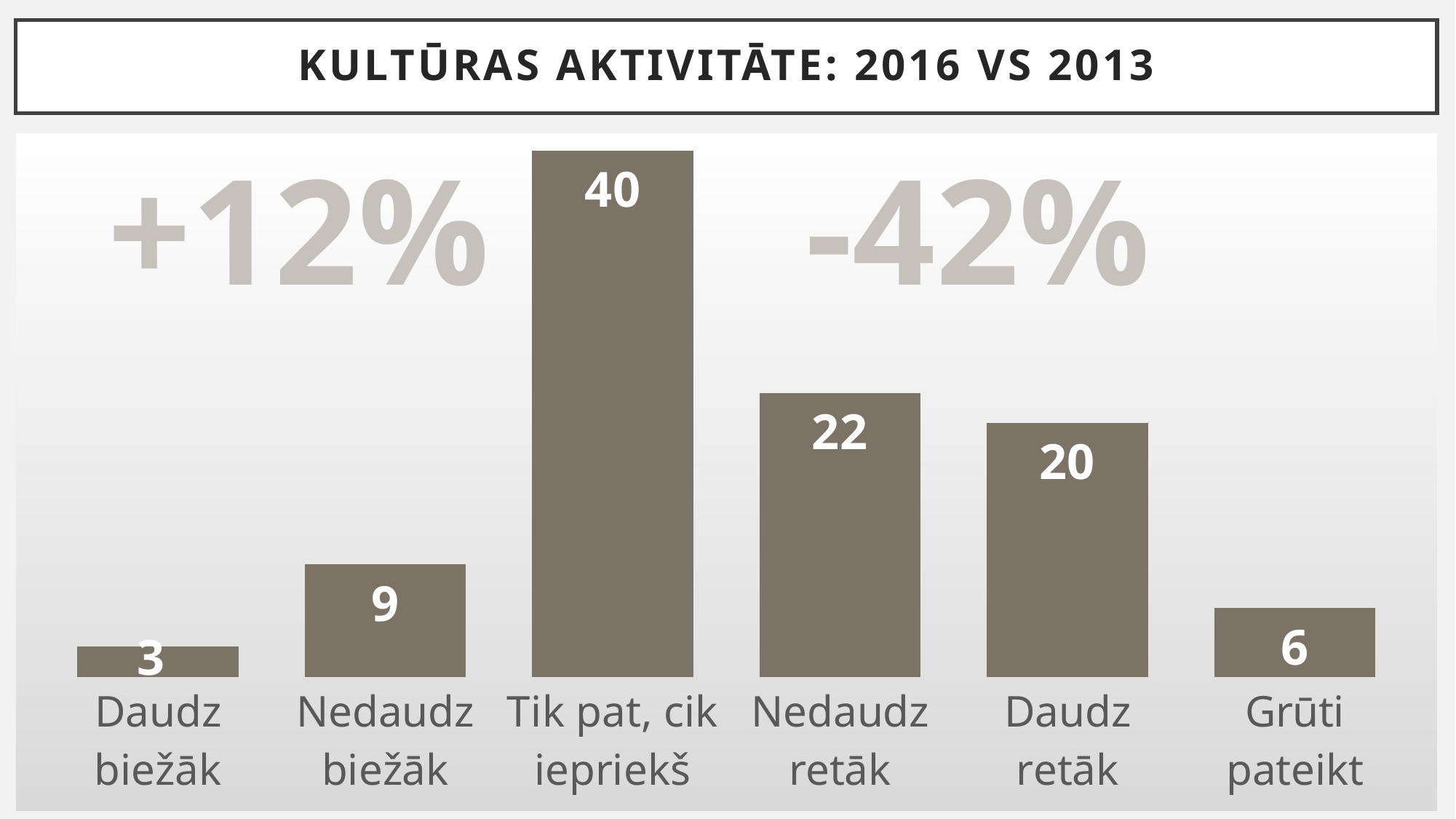
What is the value for "Grūti pateikt"? 6 Which is larger, the value for "Nedaudz biežāk" or the value for "Grūti pateikt"? Nedaudz biežāk What is the value for "Nedaudz retāk"? 22 What is the value for "Tik pat, cik iepriekš"? 40 How many categories are shown in the chart? 6 Which category has the lowest value? Daudz biežāk What is the title of the chart? KULTŪRAS AKTIVITĀTE: 2016 VS 2013 Which category has the highest value? Tik pat, cik iepriekš What is the difference between the values for "Tik pat, cik iepriekš" and "Nedaudz biežāk"? 31 What is the difference between the values for "Nedaudz retāk" and "Daudz retāk"? 2 What kind of chart is shown on the slide? bar chart What is the value for "Daudz biežāk"? 3